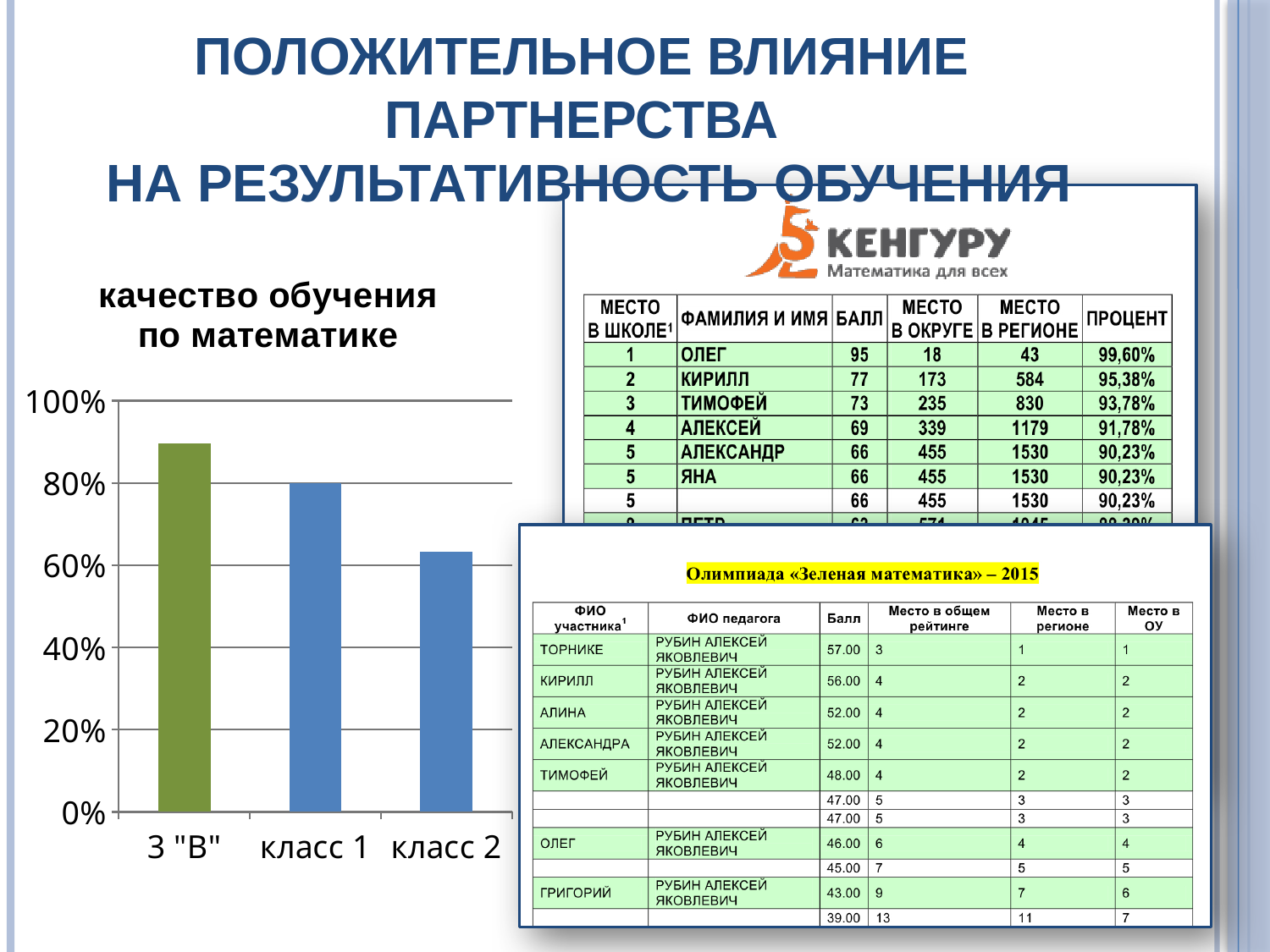
Is the value for класс 2 greater or less than 80%? less What is the value for класс 1 in the bar chart? 80% Do the values rise or fall from left to right along the x axis of the bar chart? fall Which is larger, the value for 3 "В" or the value for класс 1? 3 "В" How many categories are shown on the x axis of the bar chart? 3 Is the value for 3 "В" greater or less than 80%? greater Which category has the lowest value in the bar chart? класс 2 What is the title of the bar chart? качество обучения по математике Is the value for класс 2 greater or less than 60%? greater Which is larger, the value for класс 1 or the value for класс 2? класс 1 Which category has the highest value in the bar chart? 3 "В" What kind of chart is shown on the slide? bar chart